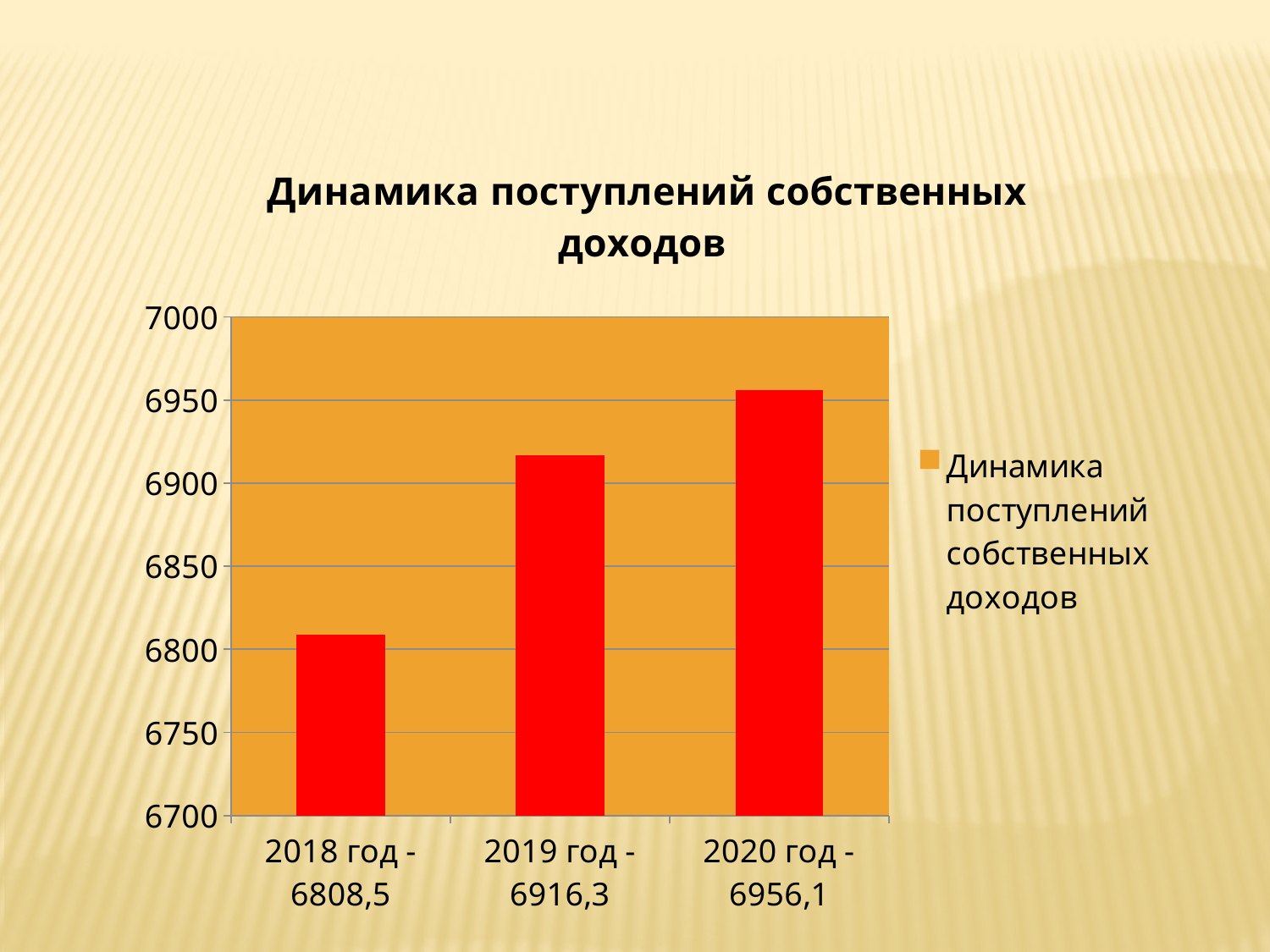
What is the difference between the values for 2019 год and 2018 год? 107,8 Which is larger, the value for 2019 год or the value for 2020 год? 2020 год What is the value for 2020 год? 6956,1 Is the value for 2018 год greater or less than 6850? less Do the values rise or fall from 2018 год to 2020 год? rise What is the value for 2018 год? 6808,5 What is the value for 2019 год? 6916,3 How many years are shown on the x axis? 3 Which year has the lowest value? 2018 год What kind of chart is shown on the slide? bar chart What is the difference between the values for 2020 год and 2019 год? 39,8 Which year has the highest value? 2020 год